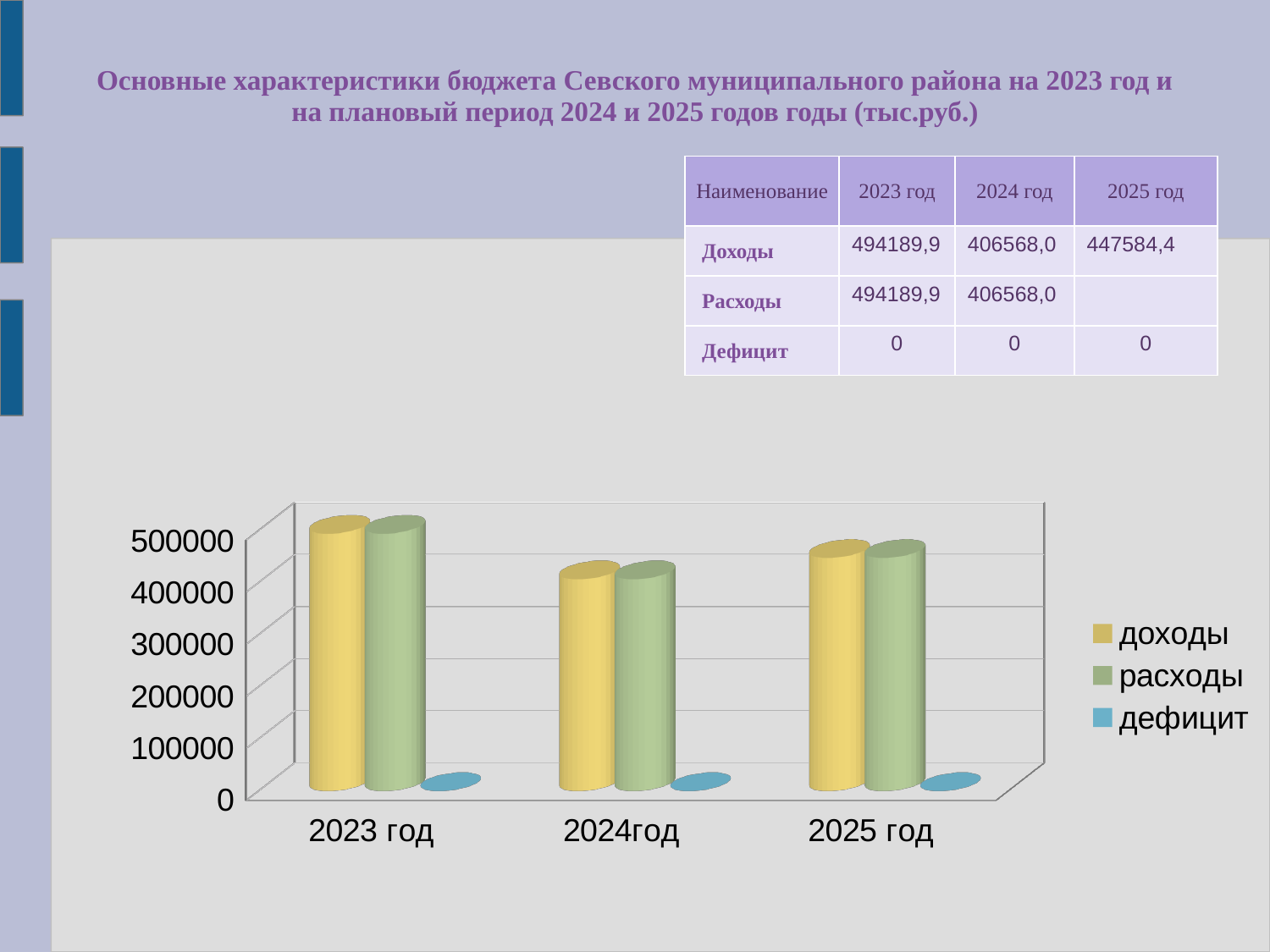
Which is larger in the chart, доходы for 2023 год or доходы for 2024год? 2023 год Which series is shown in yellow in the chart legend? доходы Which year has the highest доходы bar in the chart? 2023 год Is the расходы value for 2024год greater or less than 500000? less What is the дефицит value plotted for 2023 год? 0 Do the доходы values rise or fall from 2023 год to 2024год? fall Which year has the lowest доходы bar in the chart? 2024год How many series does the chart legend list? 3 How many year categories are shown on the x axis of the chart? 3 Is the доходы value for 2023 год greater or less than 400000? greater What kind of chart is shown on the slide? bar chart Is the доходы value for 2025 год greater or less than 500000? less